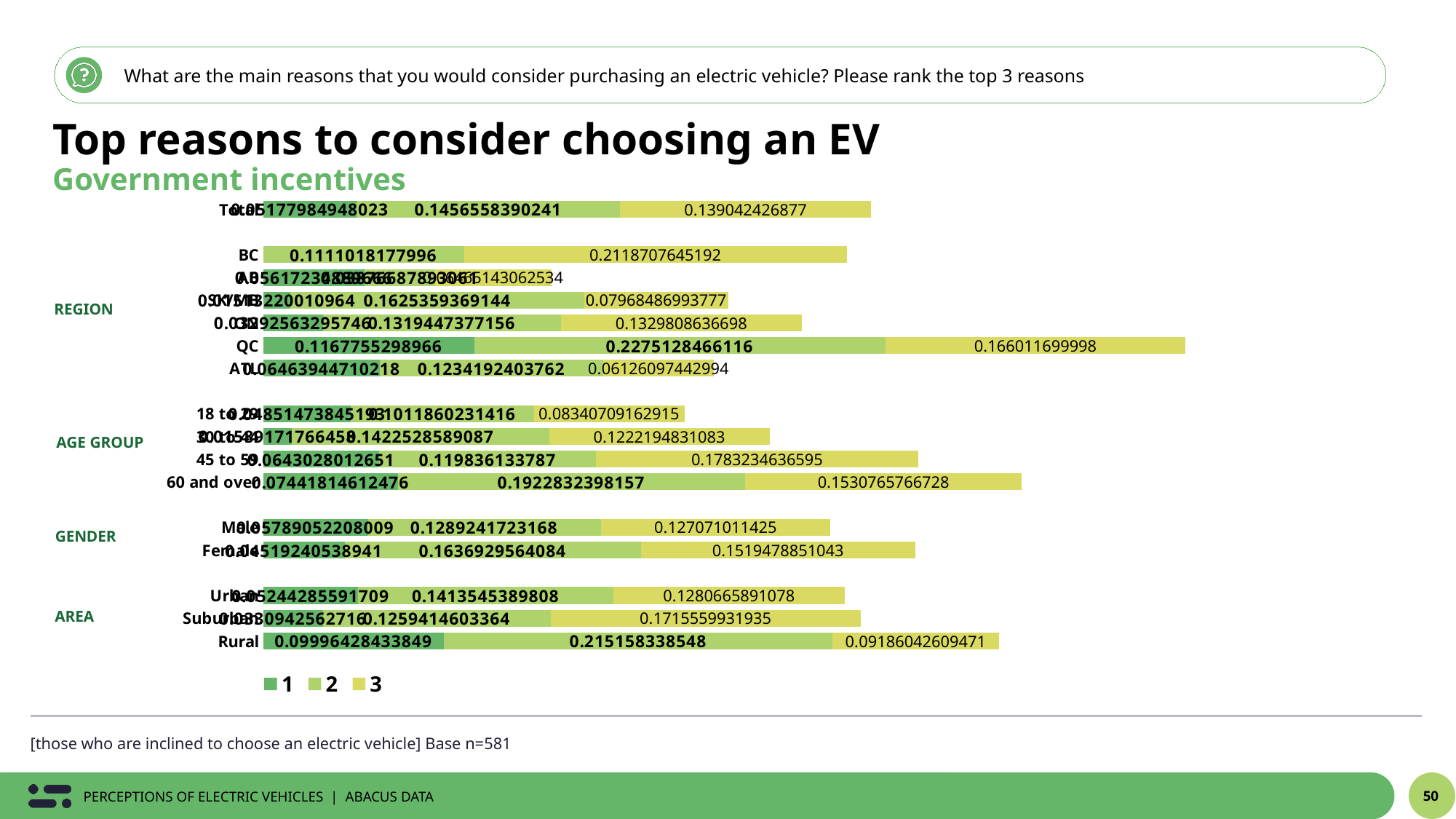
What is the value of series 1 for Rural? 0.09996428433849 What is the value of series 2 for QC? 0.2275128466116 What is the value of series 2 for 60 and over? 0.1922832398157 How many series does the legend list? 3 Which category has the longest stacked bar overall? QC What kind of chart is shown on the slide? Stacked bar chart Which is larger for Rural: series 2 or series 3? Series 2 What is the difference between series 2 and series 3 for QC? 0.0615011466136 What is the value of series 3 for 45 to 59? 0.1783234636595 What is the value of series 3 for Suburban? 0.1715559931935 What is the subtitle of the chart shown on the slide? Government incentives What is the value of series 3 for Female? 0.1519478851043